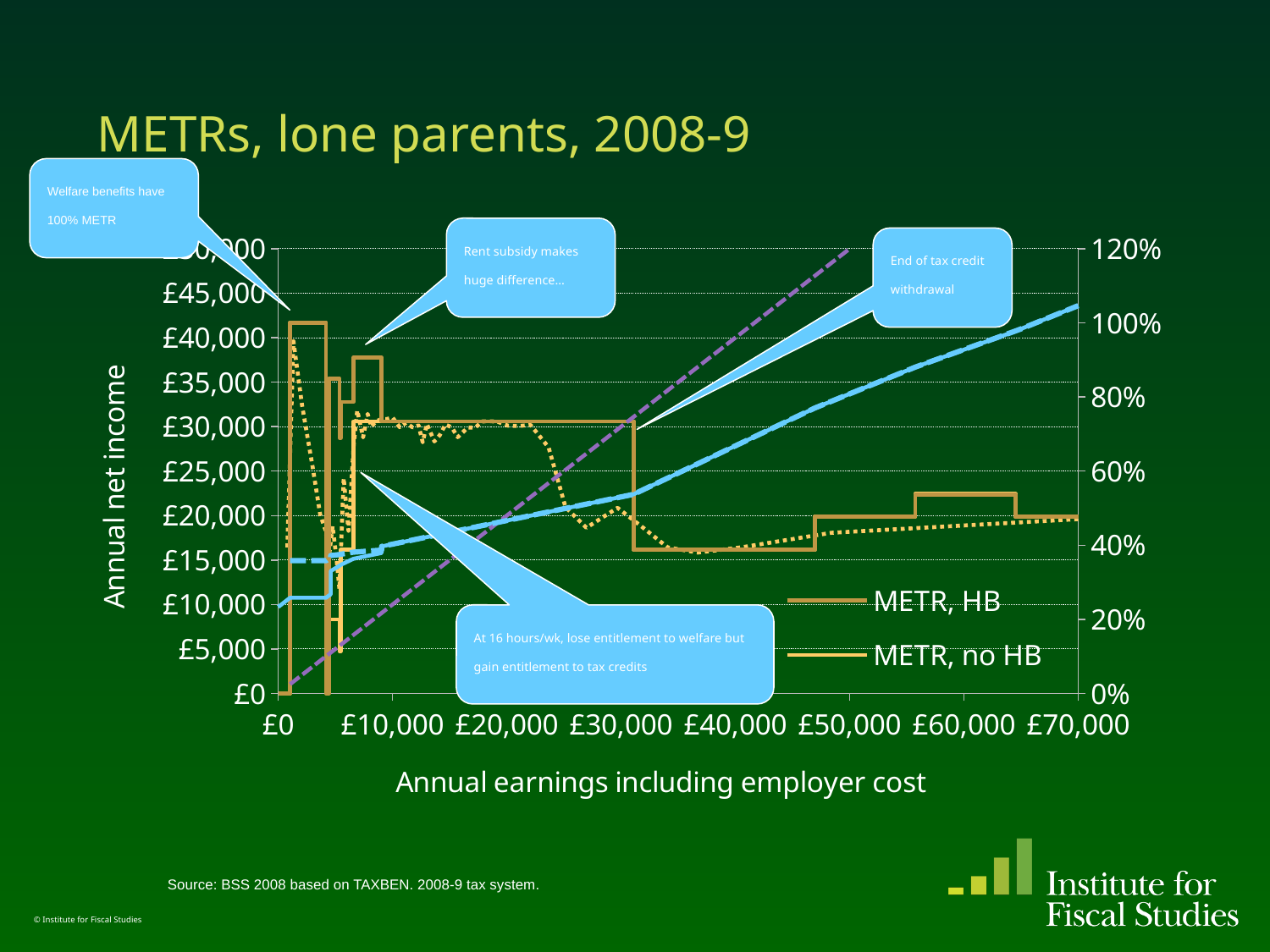
Is the value of the METR, no HB line at annual earnings of £60,000 greater or less than 80%? less How many tick labels are shown on the x axis? 8 What kind of chart is shown on the slide? line chart What is the title of the chart? METRs, lone parents, 2008-9 How many series does the legend list? 2 Does the solid blue line (annual net income) rise or fall as annual earnings increase from £40,000 to £70,000? rise Is the value of the METR, no HB line at annual earnings of £40,000 greater or less than 60%? less What is the label of the x axis? Annual earnings including employer cost Is the value of the METR, no HB line at annual earnings of £60,000 greater or less than 40%? greater